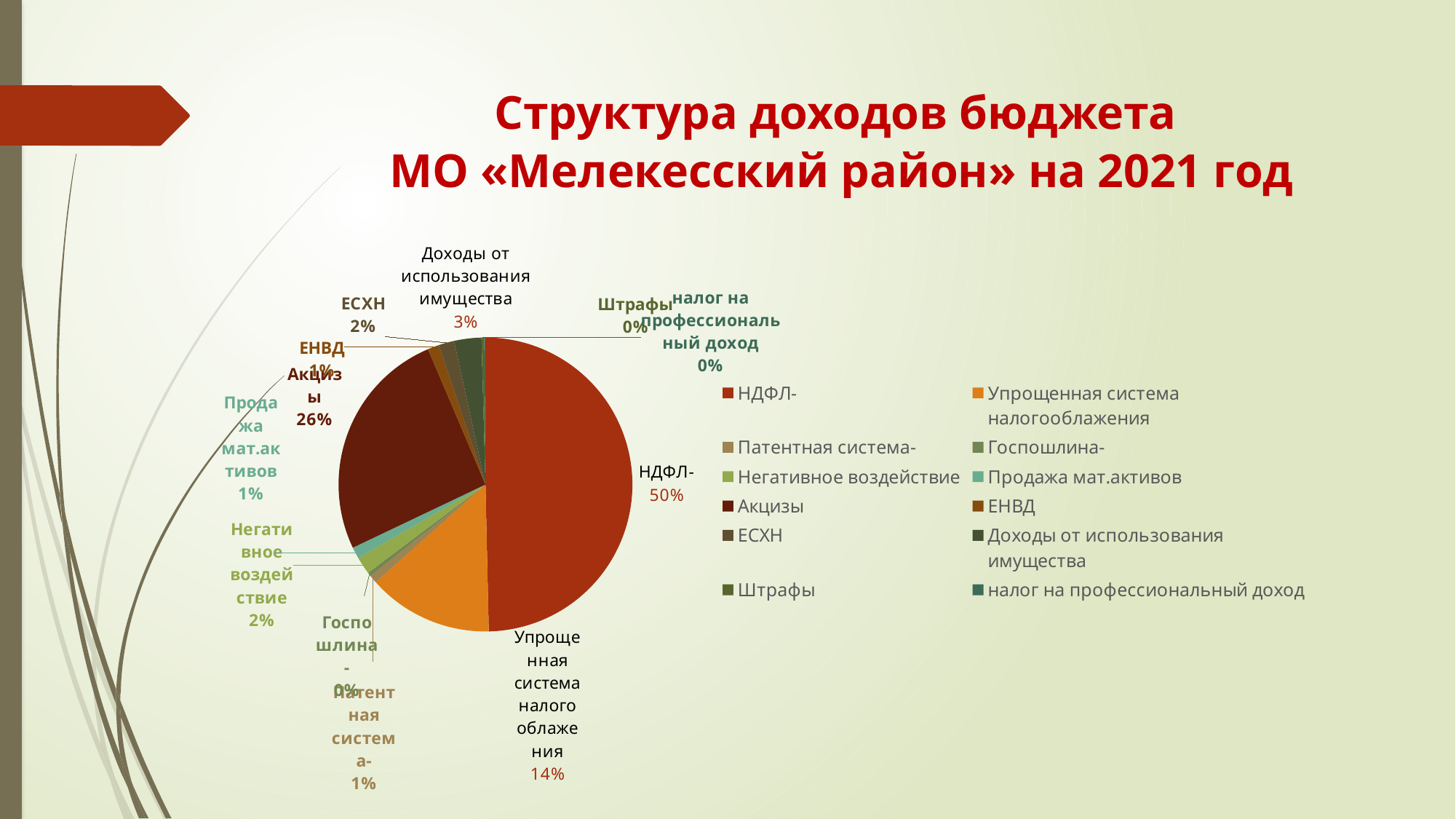
How many entries does the legend list? 12 What is the value shown for Упрощенная система налогообложения? 14% Which category has the largest share of the pie? НДФЛ What is the value shown for Негативное воздействие? 2% What kind of chart is shown on the slide? pie chart Which is larger, the share of Акцизы or the share of Упрощенная система налогообложения? Акцизы What share of the pie does НДФЛ have? 50% What is the difference between the shares of НДФЛ and Акцизы? 24% What is the title of the slide? Структура доходов бюджета МО «Мелекесский район» на 2021 год What is the value shown for Доходы от использования имущества? 3% What is the value shown for Штрафы? 0% What share of the pie does Акцизы have? 26%